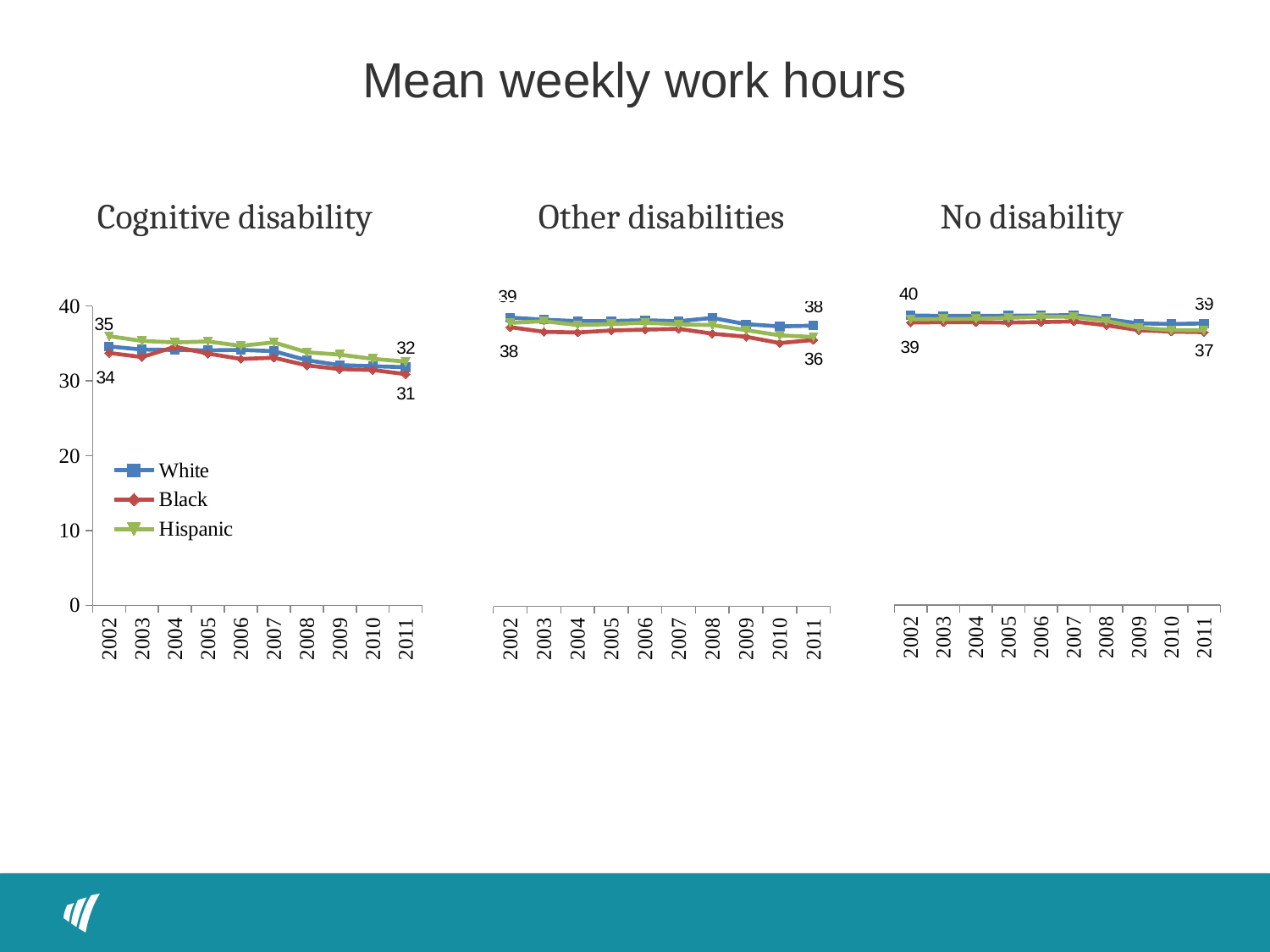
In the 'Cognitive disability' chart, what is the labelled value for Hispanic in 2002? 35 In the 'Cognitive disability' chart, what is the labelled value for Black in 2011? 31 In the 'Other disabilities' chart, what is the labelled value for White in 2011? 38 How many years are shown on the x axis of the 'No disability' chart? 10 In the 'Cognitive disability' chart, does the Hispanic line rise or fall from 2002 to 2011? fall What are the three legend entries on the 'Cognitive disability' chart? White, Black, Hispanic How many series does the legend on the 'Cognitive disability' chart list? 3 In the 'No disability' chart, what is the labelled value for White in 2002? 40 In the 'Cognitive disability' chart, is the value for White in 2006 greater or less than 30? greater In the 'Other disabilities' chart, which is larger in 2011, the White value or the Black value? White What kind of chart is the 'Cognitive disability' chart? line chart In the 'No disability' chart, what is the difference between the labelled White and Black values in 2011? 2